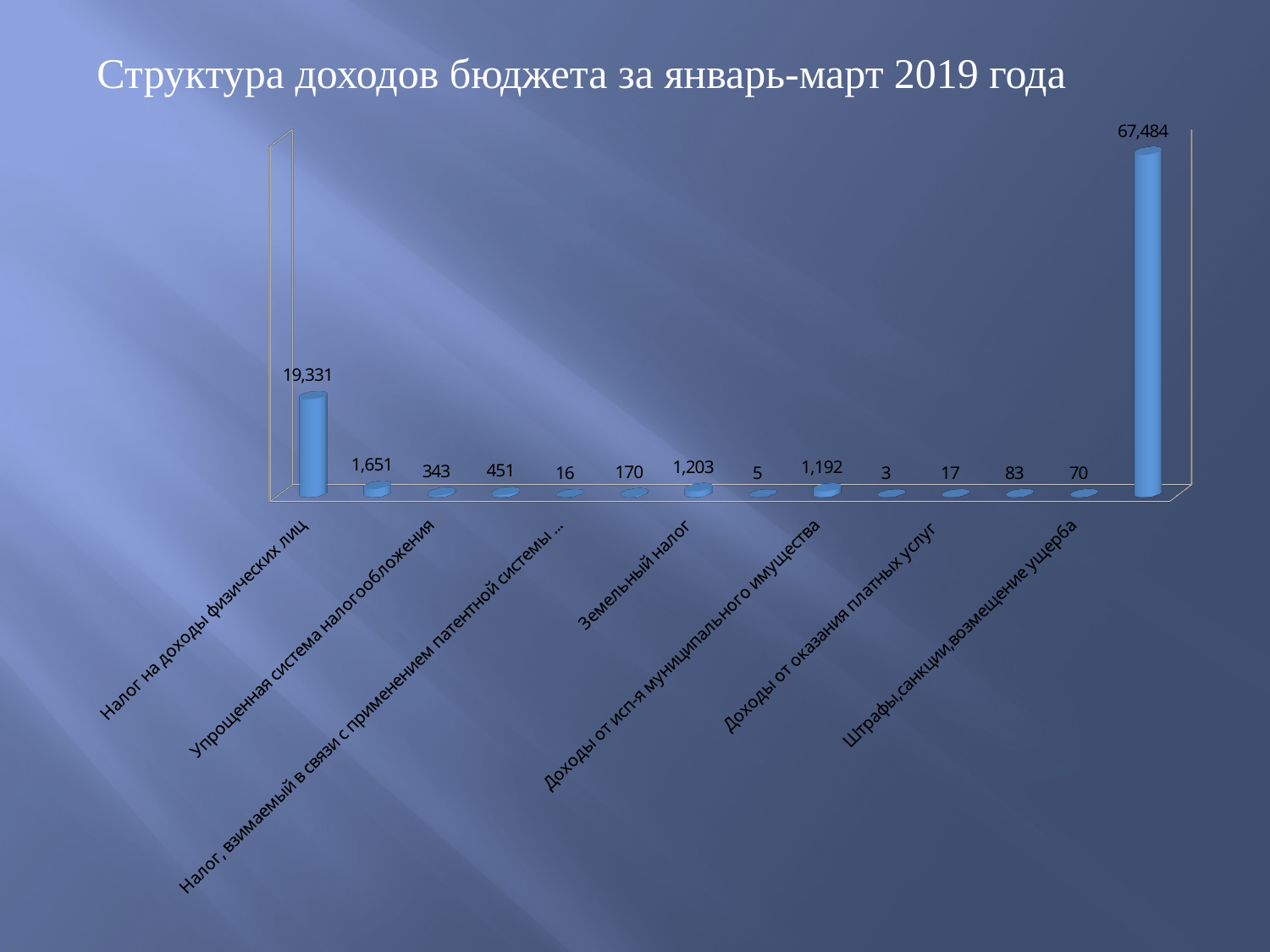
What kind of chart is shown on the slide? Bar chart What is the value for Штрафы,санкции,возмещение ущерба? 70 Which is larger: the value for Земельный налог or the value for Доходы от исп-я муниципального имущества? Земельный налог What is the value of the tallest bar, at the far right of the chart? 67,484 How many bars are plotted on the chart? 14 What is the value for Земельный налог? 1,203 What is the difference between the first bar (19,331) and the second bar (1,651)? 17,680 What is the value for Доходы от исп-я муниципального имущества? 1,192 Which is larger: the value for Налог на доходы физических лиц or the value for Земельный налог? Налог на доходы физических лиц What is the value for Налог на доходы физических лиц? 19,331 What is the title of the chart? Структура доходов бюджета за январь-март 2019 года What is the smallest value shown on the chart? 3